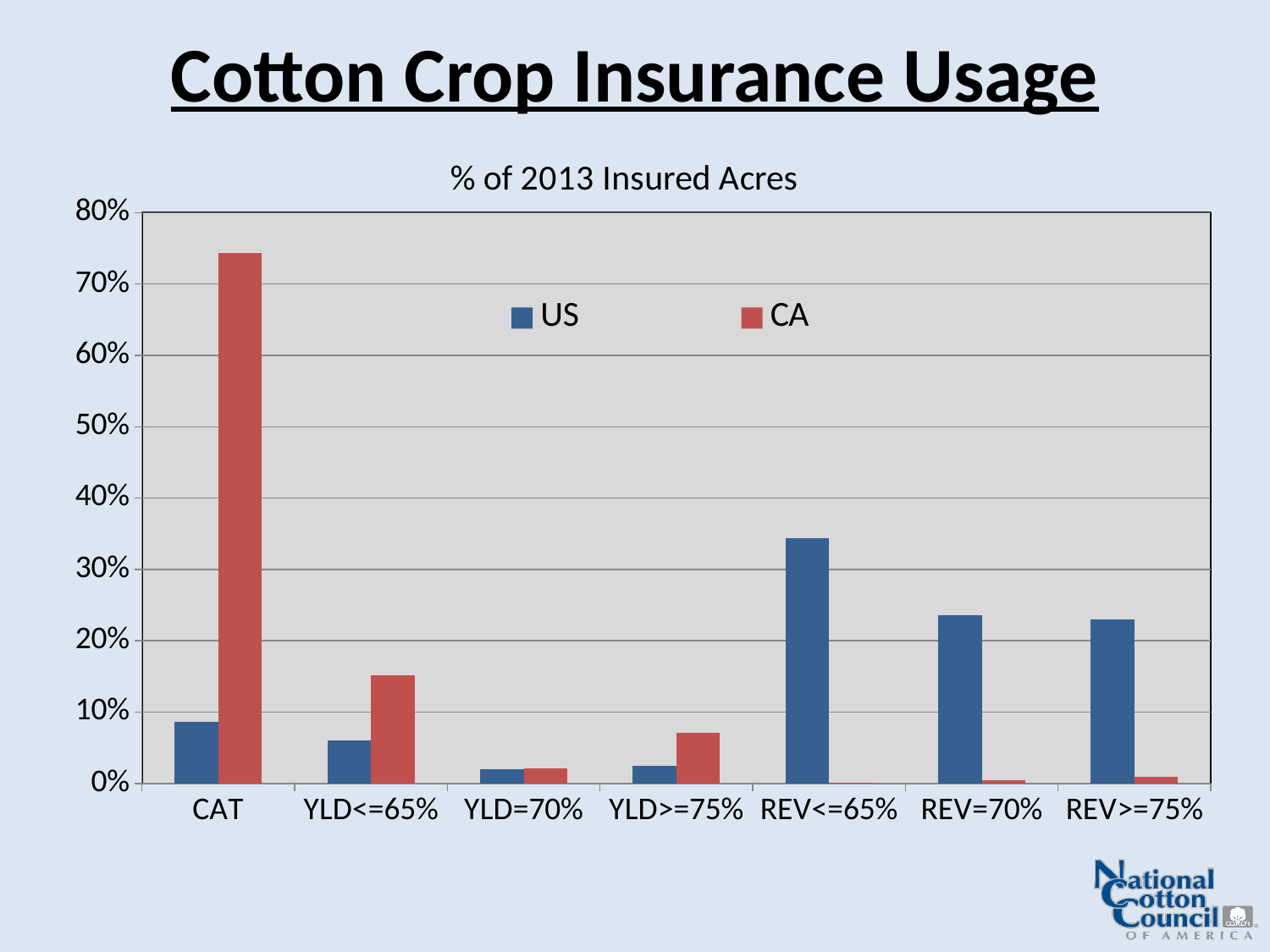
For REV<=65%, which series has the larger value, US or CA? US How many categories are shown on the x axis? 7 What is the subtitle shown above the chart's plot area? % of 2013 Insured Acres How many series does the legend list? 2 Is the CA value for CAT greater or less than 70%? greater Is the CA value for YLD<=65% greater or less than 10%? greater Is the US value for REV<=65% greater or less than 30%? greater For CAT, which series has the larger value, US or CA? CA Which category has the highest value for the CA series? CAT What kind of chart is shown on the slide? bar chart Which category has the highest value for the US series? REV<=65%